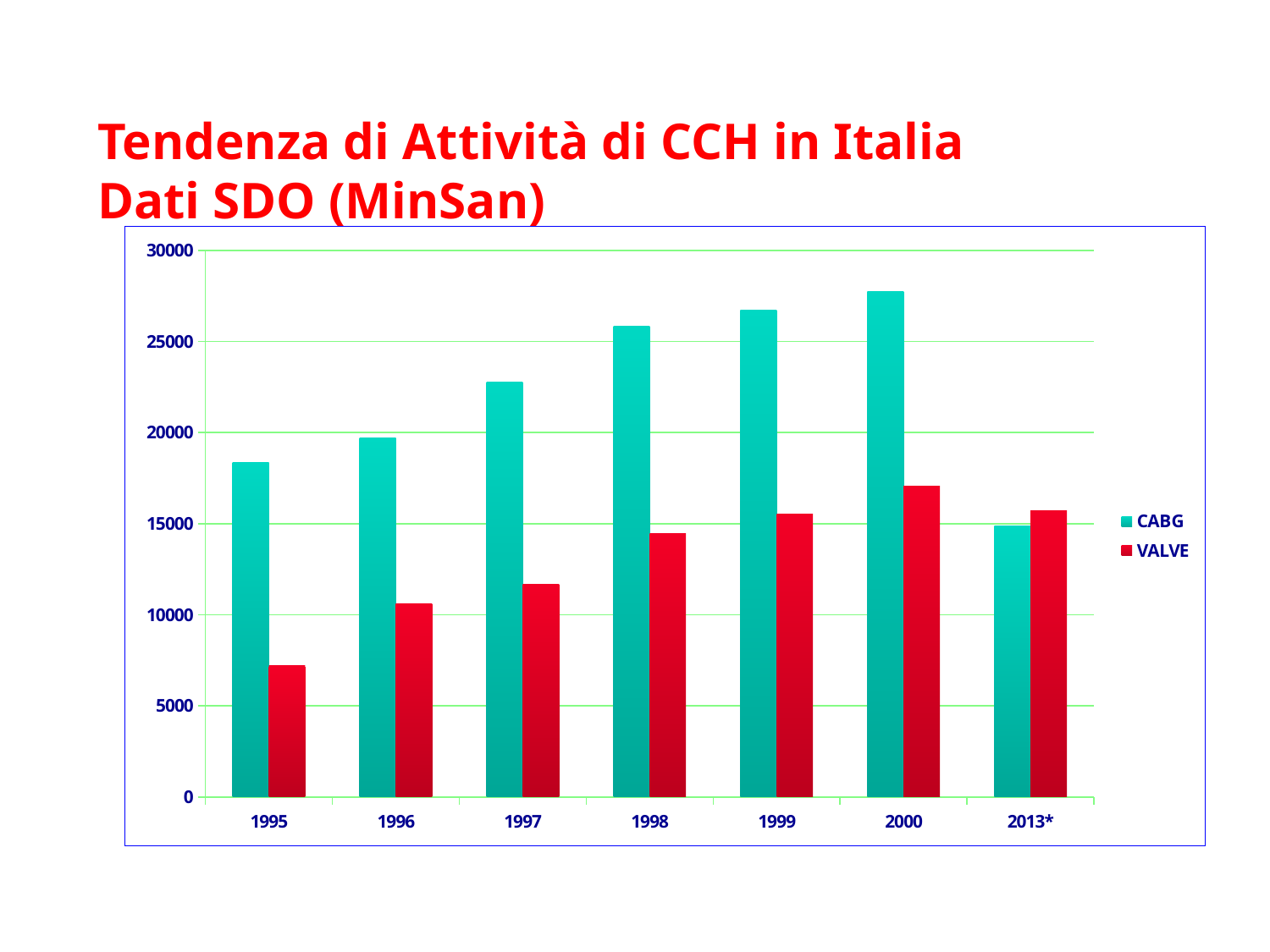
Is the CABG value for 1997 greater or less than 20000? greater Which is larger in 1998, the CABG value or the VALVE value? CABG Do the CABG values rise or fall from 1995 to 2000? rise In which year is the VALVE value highest? 2000 How many year categories are shown on the x axis? 7 What kind of chart is shown on the slide? bar chart In which year is the CABG value highest? 2000 Is the CABG value for 2000 greater or less than 25000? greater Is the VALVE value for 1995 greater or less than 10000? less How many series does the legend list? 2 In which year is the VALVE value lowest? 1995 In which year is the CABG value lowest? 2013*